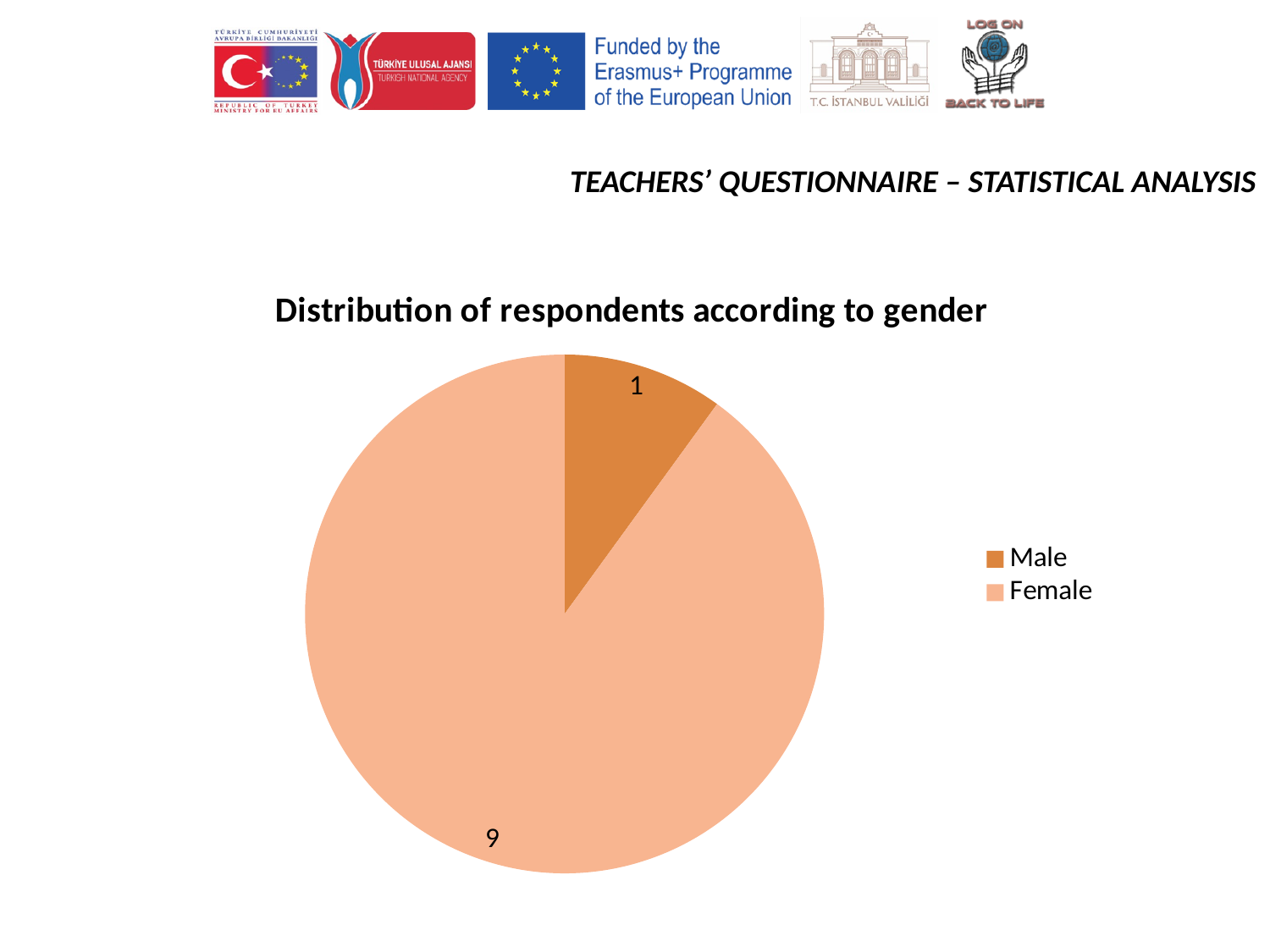
What is the value for Female? 9 What is the title of the chart? Distribution of respondents according to gender What is the total of all slices in the pie chart? 10 How many categories does the pie chart show? 2 What kind of chart is shown on the slide? Pie chart What is the value for Male? 1 What share of the pie does the Female slice represent? 90% What is the difference between the Female and Male values? 8 Which is larger, the value for Male or the value for Female? Female Which category has the largest slice? Female What share of the pie does the Male slice represent? 10% Which category has the smallest slice? Male